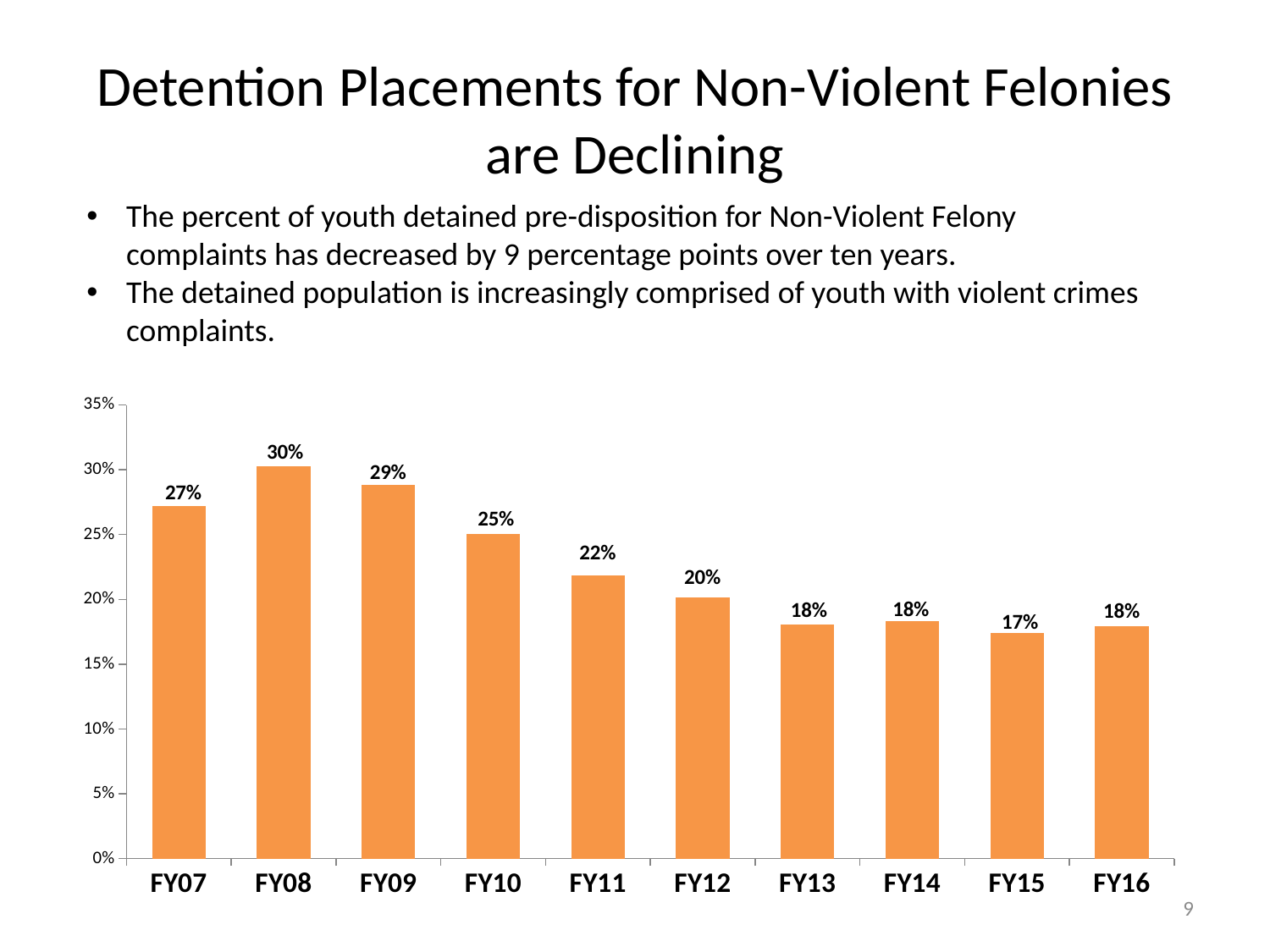
What is the difference between the values for FY08 and FY11? 8% What is the difference between the values for FY07 and FY16? 9% What is the value for FY16? 18% How many fiscal years are shown on the x axis? 10 What is the value for FY12? 20% Which is larger, the value for FY09 or the value for FY10? FY09 What is the value for FY08? 30% Is the value for FY11 greater or less than 20%? greater Which fiscal year has the lowest value? FY15 Do the values generally rise or fall from FY07 to FY16? fall What kind of chart is shown on the slide? bar chart Which fiscal year has the highest value? FY08